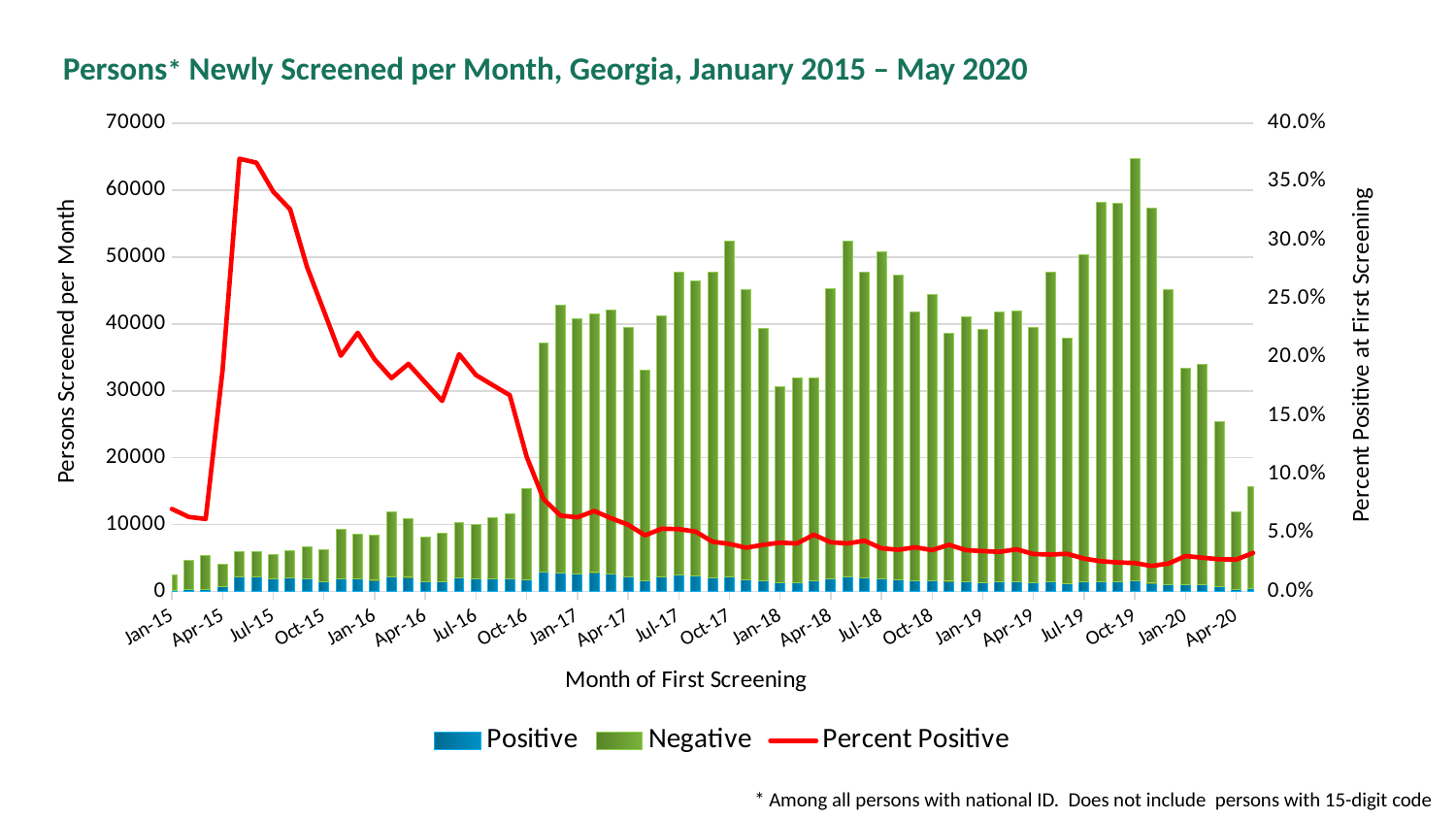
Which is larger, the total persons screened in Oct-19 or in Jan-15? Oct-19 Is the Percent Positive value for Apr-20 greater or less than 5.0%? less Does the Percent Positive line generally rise or fall from Jan-17 to Apr-20? fall Is the peak value of the Percent Positive line greater or less than 35.0%? greater What is the label of the right-hand vertical axis? Percent Positive at First Screening Is the Percent Positive value for Jan-15 greater or less than 10.0%? less How many series does the legend list? 3 In which month is the total number of persons screened highest? Oct-19 What is the title of the chart? Persons* Newly Screened per Month, Georgia, January 2015 – May 2020 What kind of chart is shown on the slide? A combination bar and line chart (stacked bars with a line)